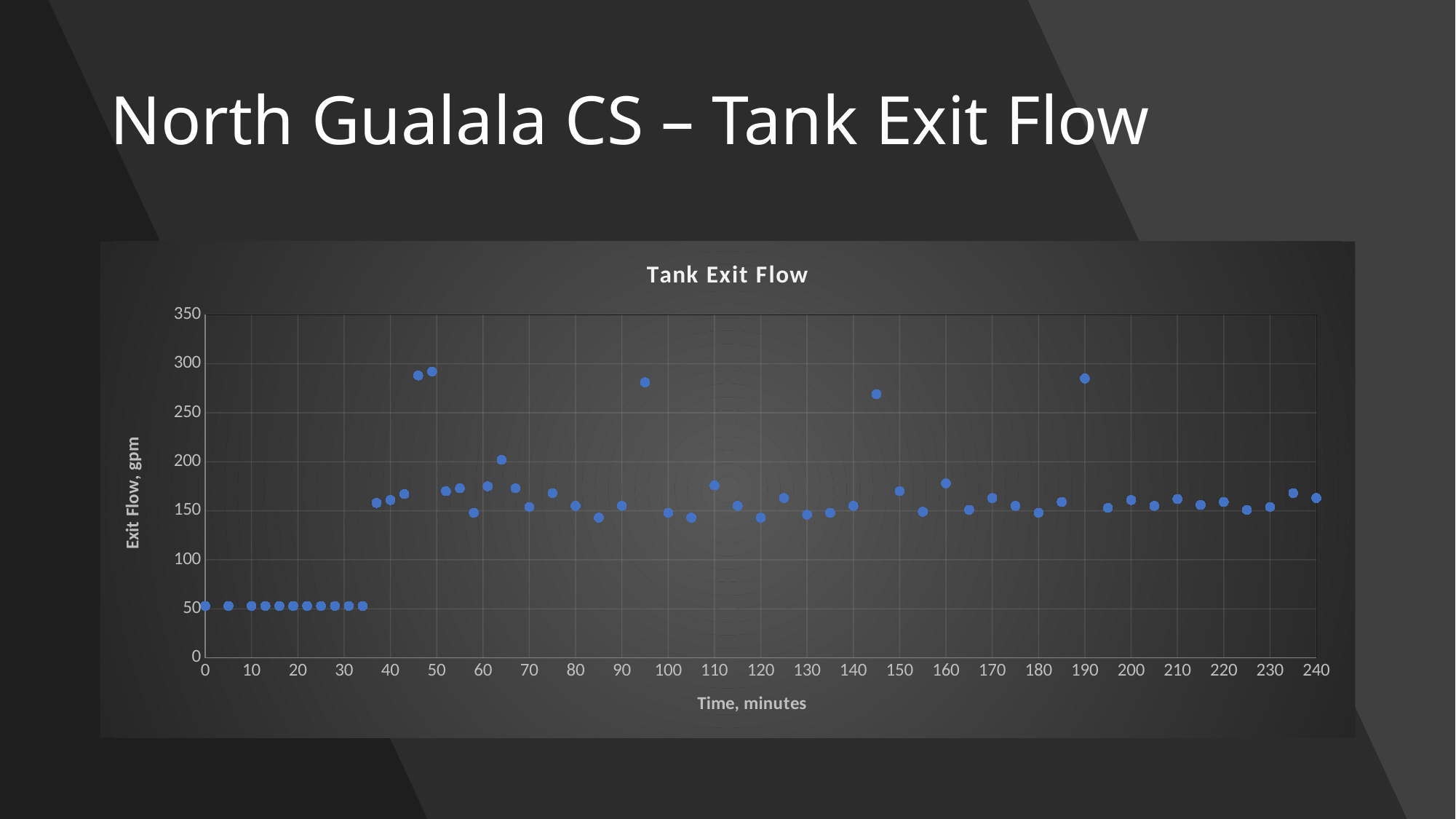
Is the value at time 240 minutes greater or less than 200? less Do the values rise or fall between time 35 minutes and time 40 minutes? rise What kind of chart is shown on the slide? scatter chart Is the value at time 190 minutes greater or less than 250? greater Is the value at time 0 minutes greater or less than 100? less Which is larger, the value at time 0 minutes or the value at time 240 minutes? time 240 minutes What is the label of the vertical axis? Exit Flow, gpm What is the title of the chart? Tank Exit Flow